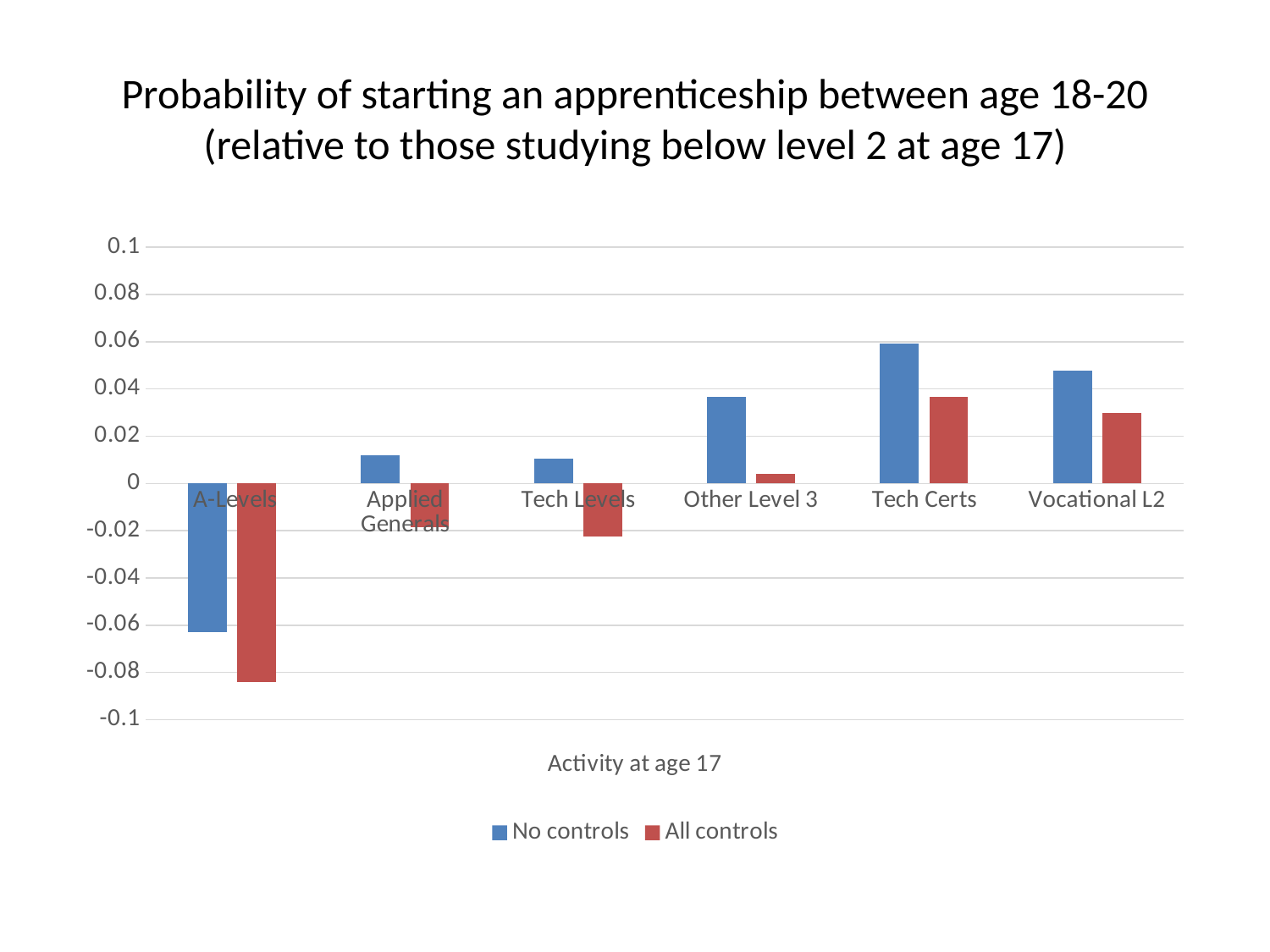
Which category has the lowest value for the All controls series? A-Levels Is the No controls value for Tech Certs greater or less than 0.04? greater Is the All controls value for A-Levels greater or less than -0.08? less How many categories are shown along the x axis? 6 For Vocational L2, which series has the larger value, No controls or All controls? No controls Which category has the highest value for the No controls series? Tech Certs Which category has the lowest value for the No controls series? A-Levels Is the No controls value for A-Levels greater or less than -0.06? less How many series does the legend list? 2 Which category has the highest value for the All controls series? Tech Certs What kind of chart is shown on the slide? Bar chart What is the title of the x axis? Activity at age 17